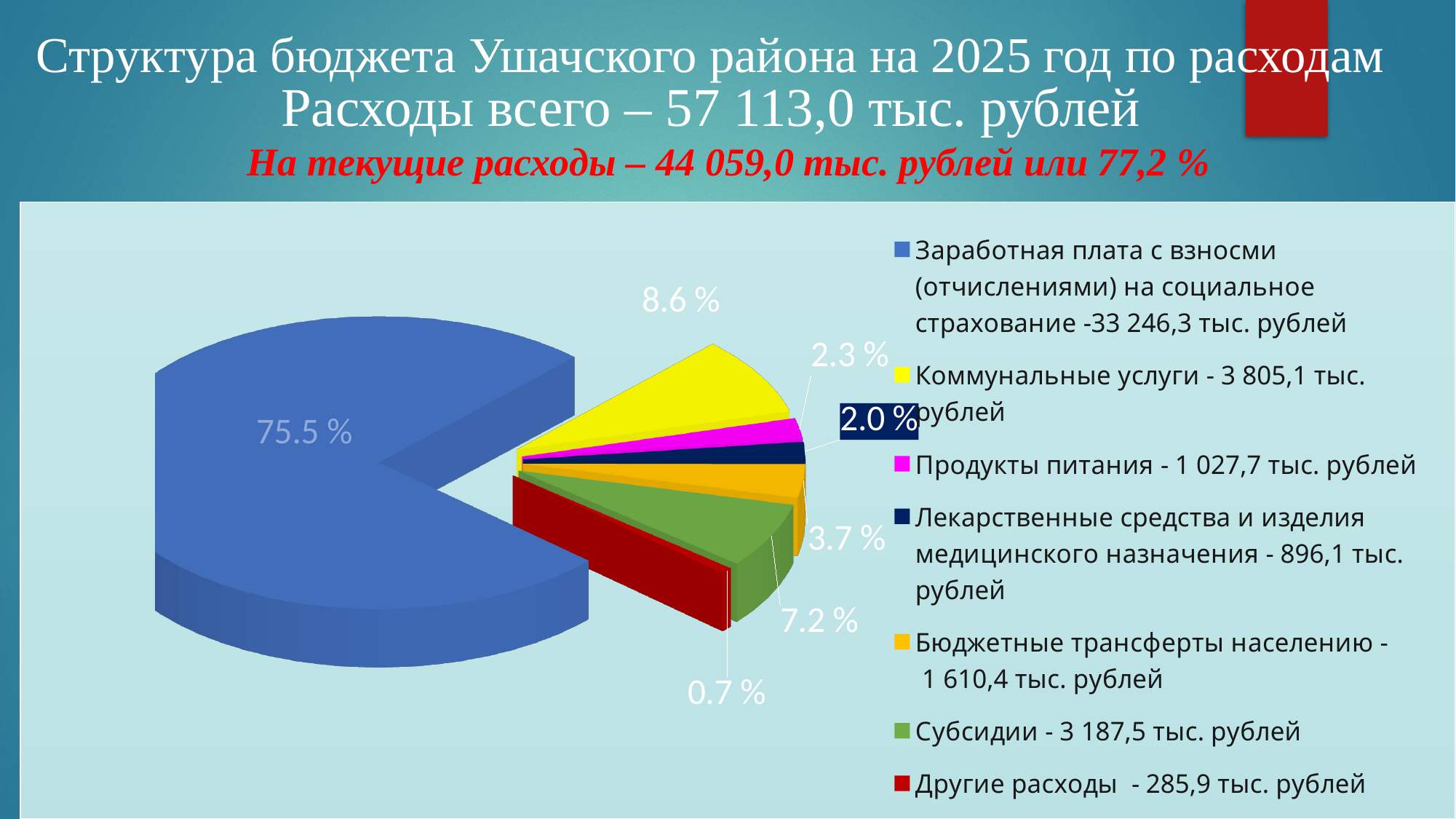
According to the legend, what is the amount for Продукты питания? 1 027,7 тыс. рублей How many slices does the pie chart have? 7 What share of the pie is labelled for Субсидии? 7.2 % Which has the larger share: Субсидии or Бюджетные трансферты населению? Субсидии According to the legend, what is the amount for Бюджетные трансферты населению? 1 610,4 тыс. рублей What share of the pie is labelled for Лекарственные средства и изделия медицинского назначения? 2.0 % Which category has the largest share of the pie? Заработная плата с взносми (отчислениями) на социальное страхование What is the difference in percentage points between the shares of Коммунальные услуги and Субсидии? 1.4 % What colour is the slice for Другие расходы? red What share of the pie is labelled for Коммунальные услуги? 8.6 % Which category has the smallest share of the pie? Другие расходы What kind of chart is shown on the slide? pie chart